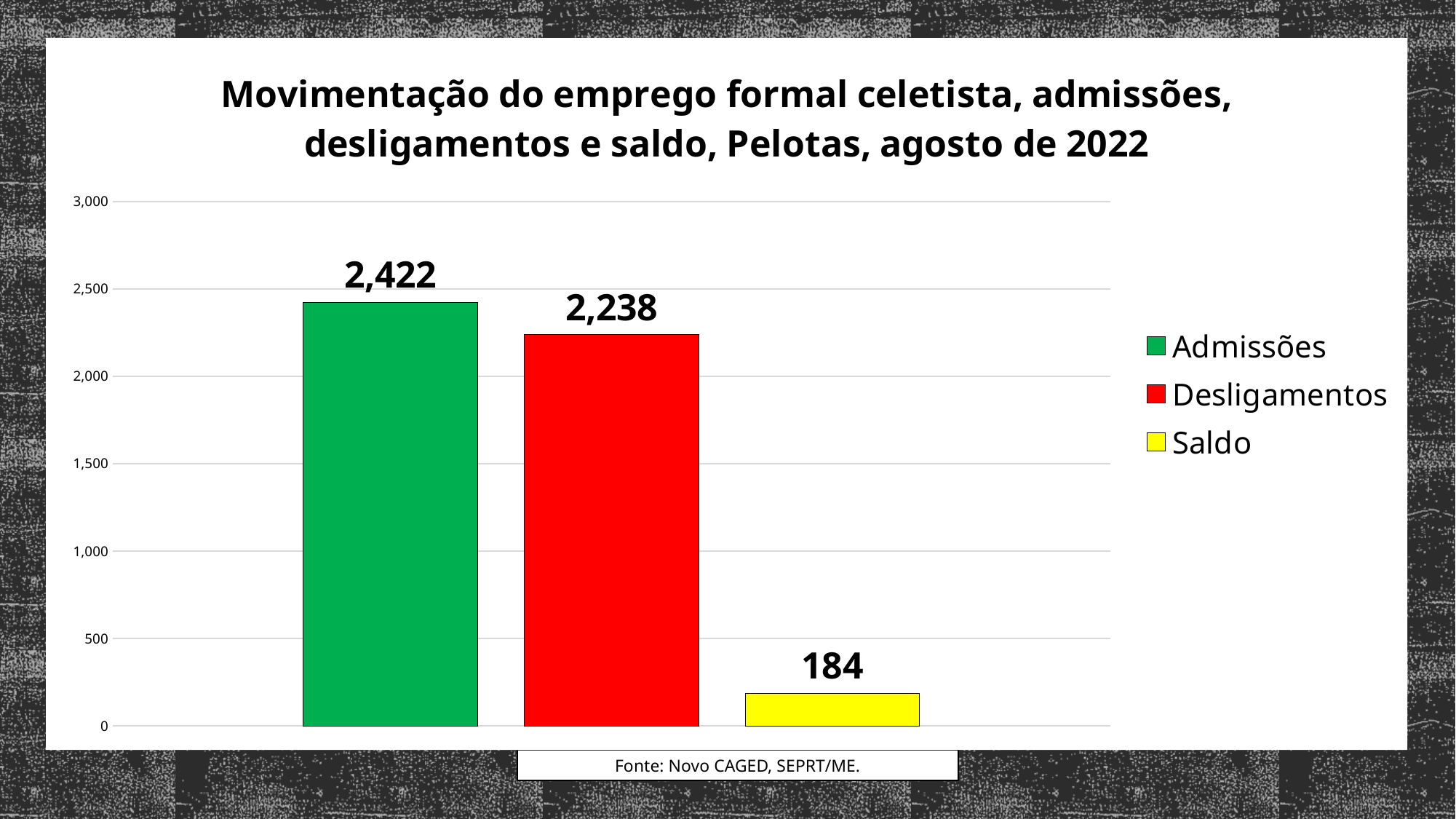
Is the value for Desligamentos greater or less than 2,000? greater Which is larger, Admissões or Desligamentos? Admissões What is the value for Desligamentos? 2,238 Is the value for Saldo greater or less than 500? less What is the value for Saldo? 184 What is the difference between Admissões and Desligamentos? 184 Which series has the highest value? Admissões Which series has the lowest value? Saldo What colour is the bar for Saldo? Yellow How many series does the legend list? 3 What kind of chart is shown? Bar chart What is the value for Admissões? 2,422